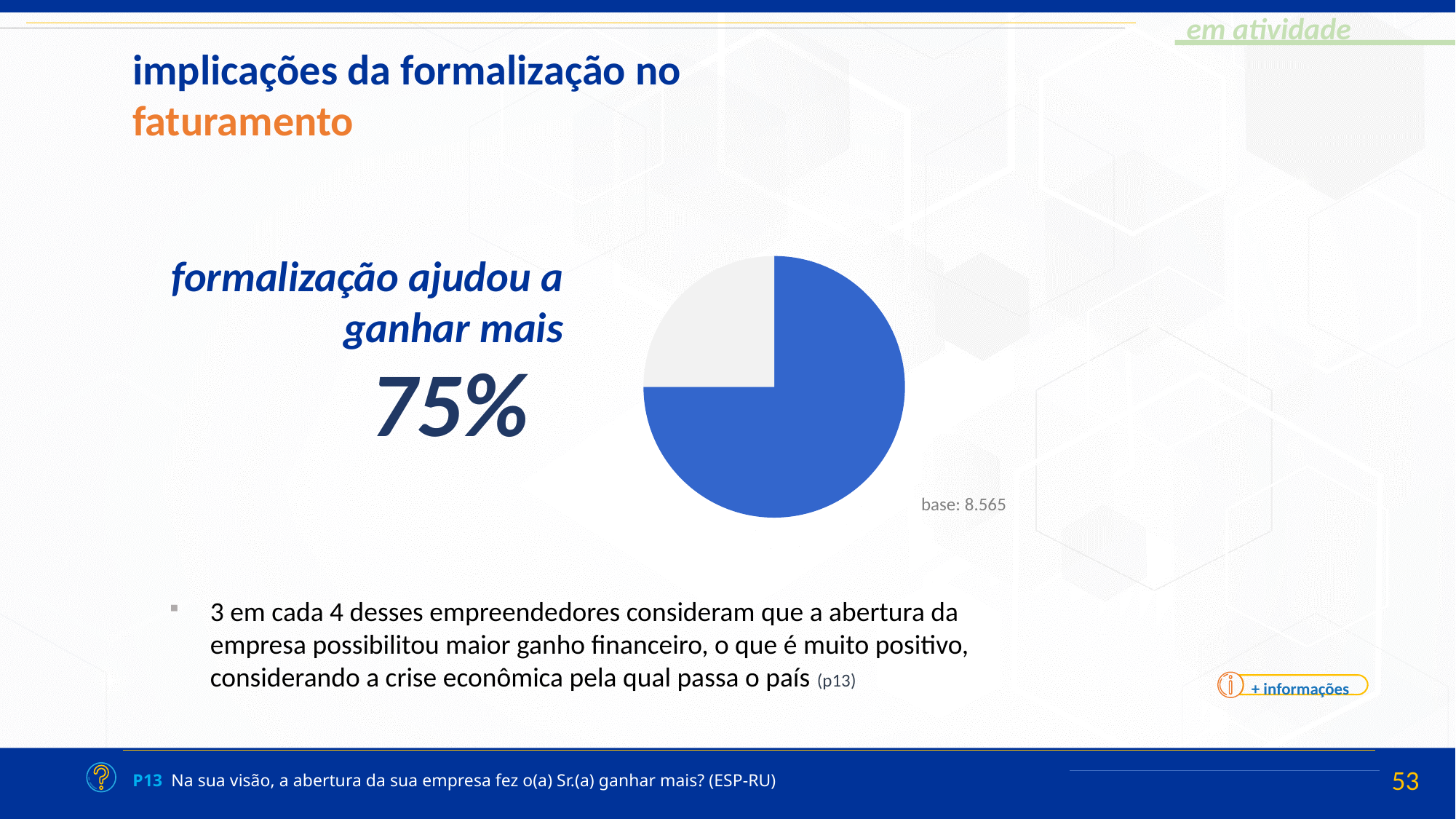
What is the base (number of respondents) shown next to the pie chart? 8.565 Is the blue slice of the pie chart greater or less than 50% of the pie? greater How many slices does the pie chart have? 2 Is the grey slice of the pie chart greater or less than 50% of the pie? less What colour is the slice representing the 75% who said formalization helped them earn more? blue What type of chart is shown on the slide? pie chart Which slice of the pie chart is larger, the blue one or the grey one? the blue one What is the percentage value printed next to the pie chart? 75% What share of the pie chart is represented by the blue slice (formalização ajudou a ganhar mais)? 75%